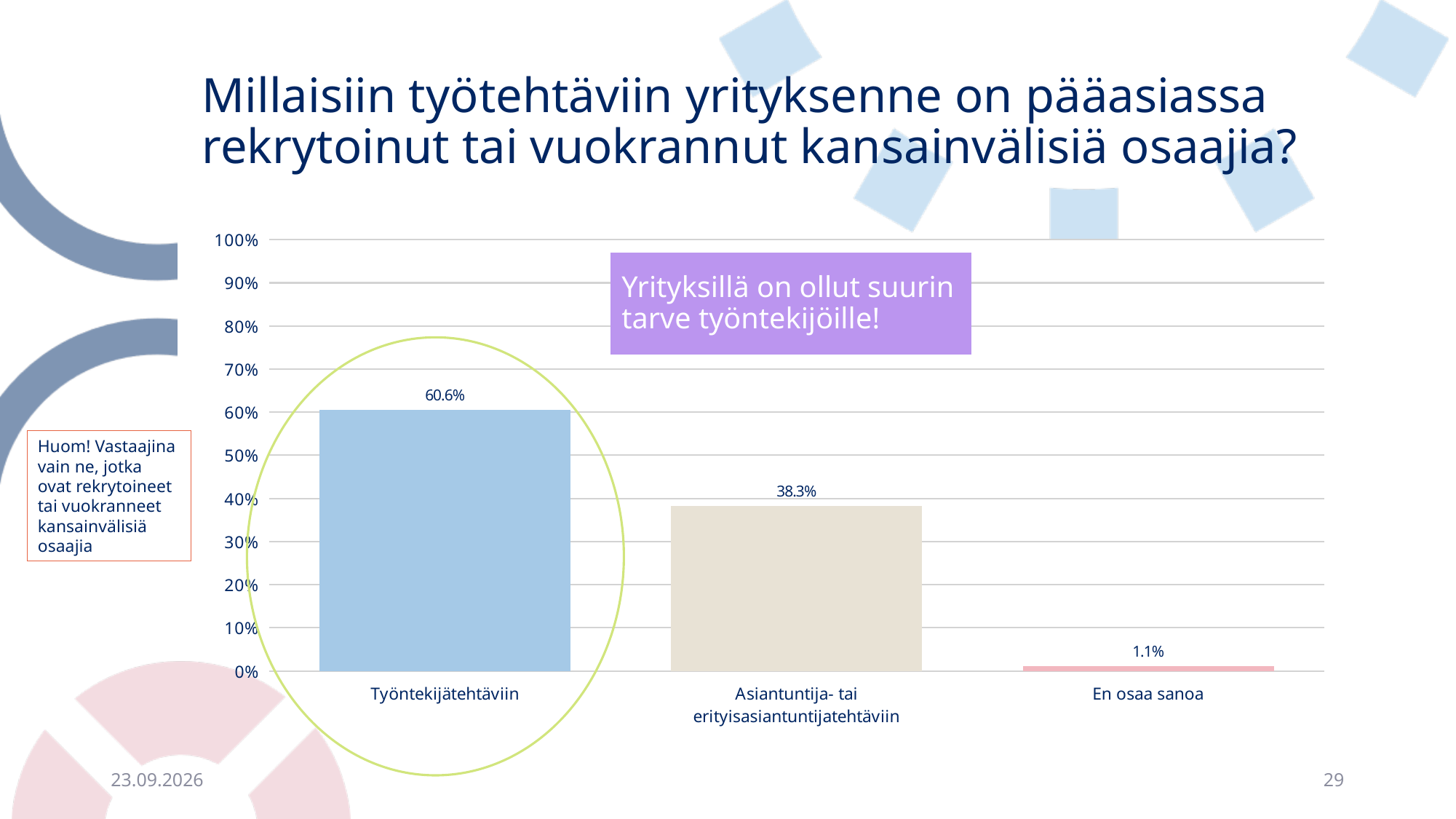
What is the value for Työntekijätehtäviin? 60.6% Which is larger, the value for Asiantuntija- tai erityisasiantuntijatehtäviin or the value for En osaa sanoa? Asiantuntija- tai erityisasiantuntijatehtäviin Is the value for Työntekijätehtäviin greater or less than 50%? greater What kind of chart is shown on the slide? bar chart What is the difference between the values for Työntekijätehtäviin and Asiantuntija- tai erityisasiantuntijatehtäviin? 22.3% Is the value for Asiantuntija- tai erityisasiantuntijatehtäviin greater or less than 40%? less What is the value for En osaa sanoa? 1.1% Which category has the lowest value? En osaa sanoa What is the highest value shown on the vertical axis? 100% Which category has the highest value? Työntekijätehtäviin How many categories are shown in the chart? 3 What is the value for Asiantuntija- tai erityisasiantuntijatehtäviin? 38.3%